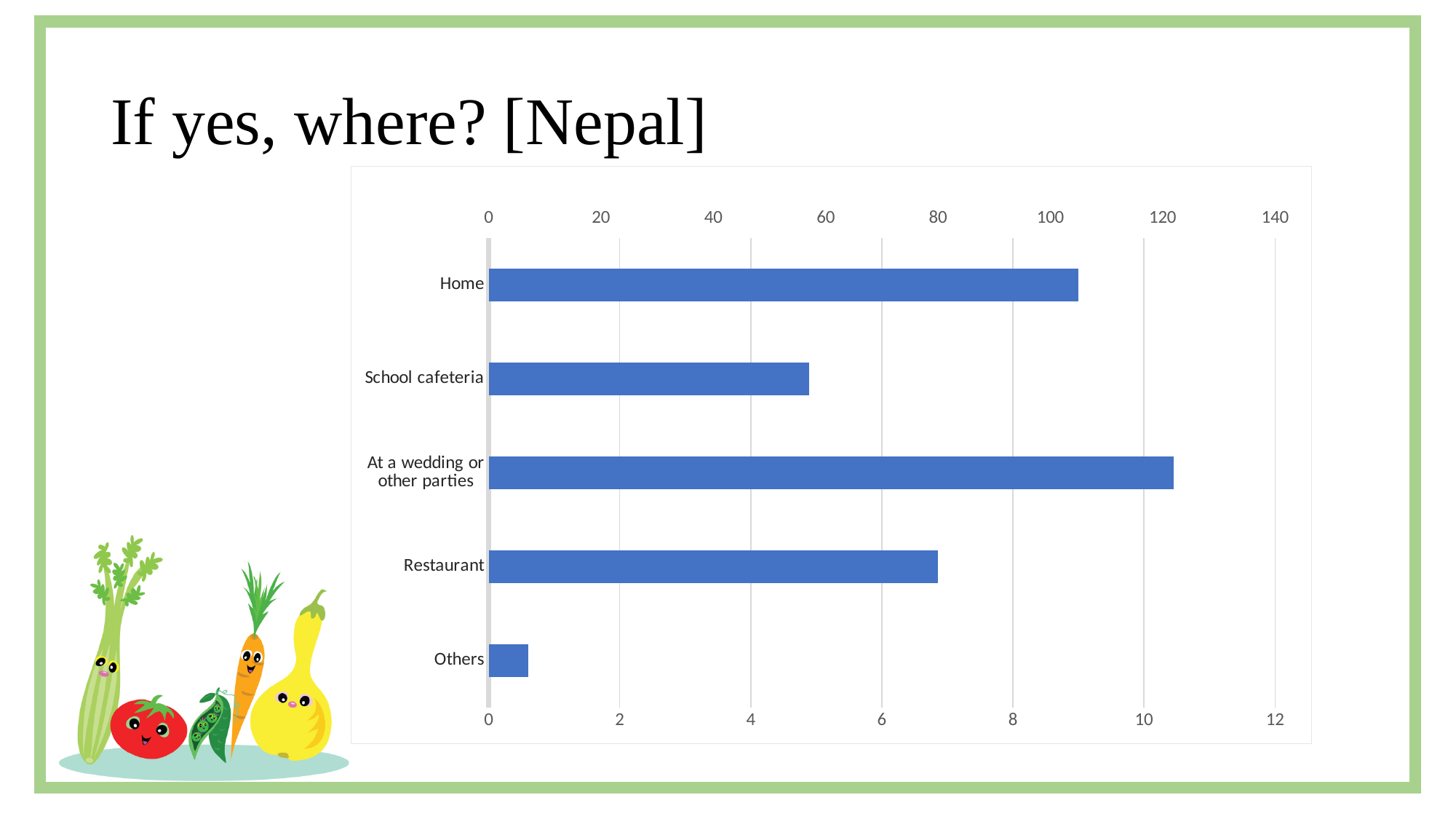
Which is larger, the value for Home or the value for School cafeteria? Home On the bottom axis, is the value for Home greater or less than 8? greater How many categories are plotted in the chart? 5 Which is larger, the value for Restaurant or the value for School cafeteria? Restaurant What colour are the bars in the chart? blue What kind of chart is shown on the slide? bar chart On the bottom axis, is the value for At a wedding or other parties greater or less than 10? greater What is the title of the slide containing the chart? If yes, where? [Nepal] Which category has the longest bar? At a wedding or other parties Which category has the shortest bar? Others Which is larger, the value for At a wedding or other parties or the value for Restaurant? At a wedding or other parties